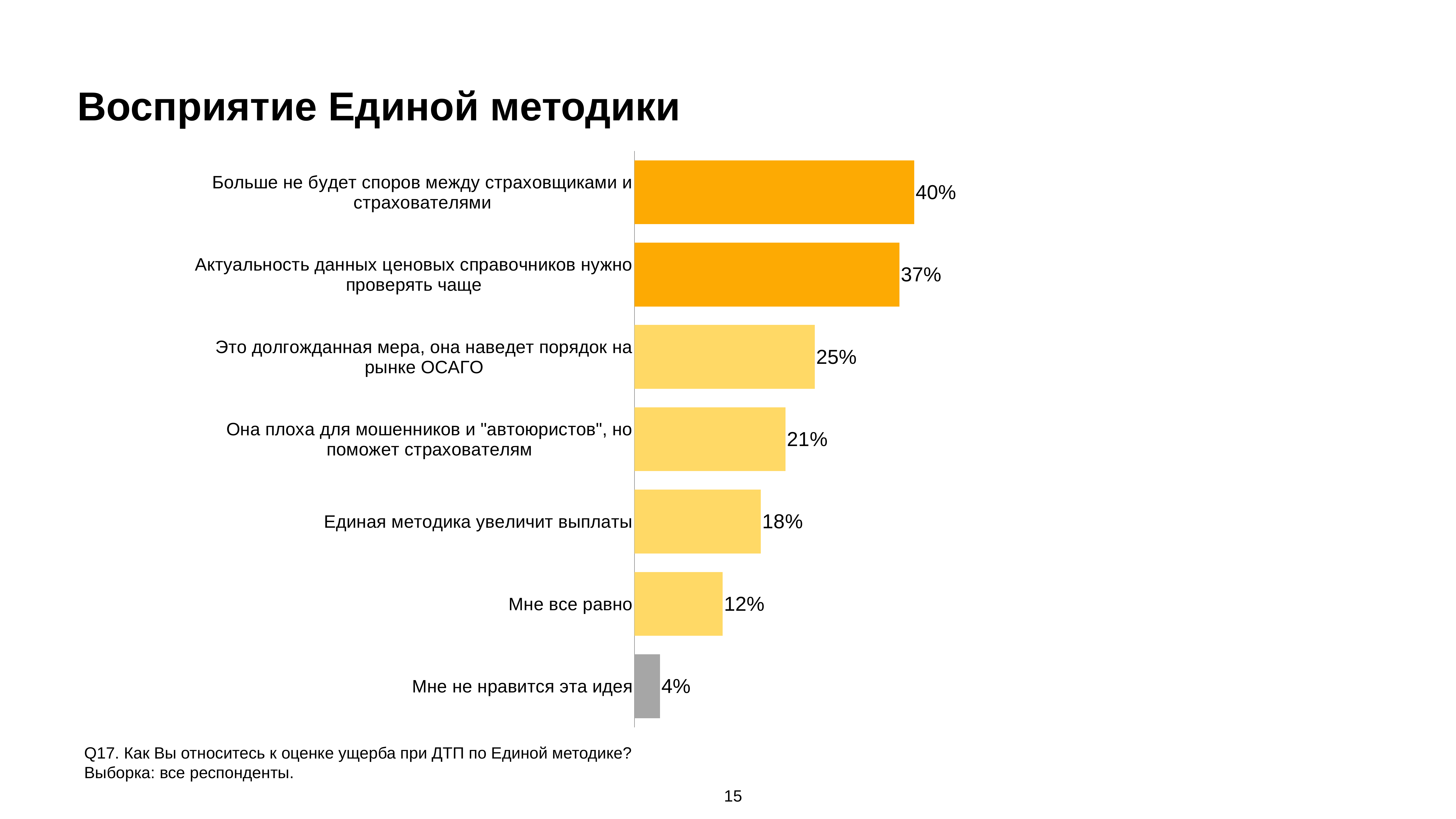
Which category has the lowest value? Мне не нравится эта идея What is the value for "Единая методика увеличит выплаты"? 18% Which is larger: the value for "Она плоха для мошенников и "автоюристов", но поможет страхователям" or the value for "Единая методика увеличит выплаты"? Она плоха для мошенников и "автоюристов", но поможет страхователям What is the value for "Мне не нравится эта идея"? 4% What kind of chart is shown on the slide? Bar chart What is the difference between the values for "Это долгожданная мера, она наведет порядок на рынке ОСАГО" and "Мне все равно"? 13% How many categories are shown in the chart? 7 What is the value for "Больше не будет споров между страховщиками и страхователями"? 40% Which category has the highest value? Больше не будет споров между страховщиками и страхователями What colour is the bar for "Мне не нравится эта идея"? Grey What is the value for "Мне все равно"? 12% What is the difference between the values for "Больше не будет споров между страховщиками и страхователями" and "Актуальность данных ценовых справочников нужно проверять чаще"? 3%